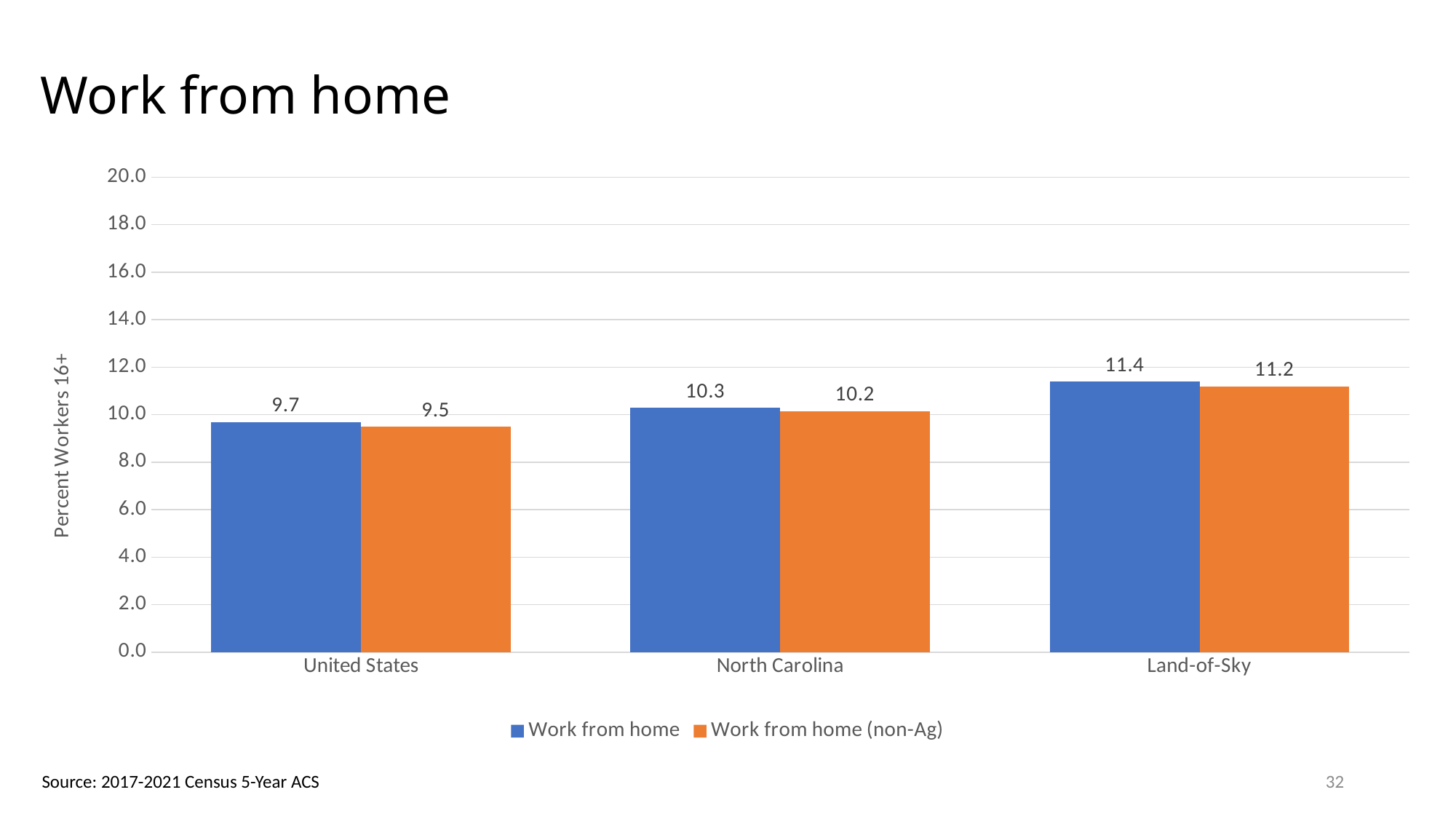
Is the 'Work from home' value for Land-of-Sky greater or less than 10.0? greater What is the 'Work from home (non-Ag)' value for North Carolina? 10.2 How many series does the legend list? 2 What is the 'Work from home' value for United States? 9.7 Which region has the lowest 'Work from home (non-Ag)' value? United States What kind of chart is shown on the slide? bar chart What is the difference between the 'Work from home' values for Land-of-Sky and United States? 1.7 Which region has the highest 'Work from home' value? Land-of-Sky What is the 'Work from home' value for Land-of-Sky? 11.4 Which is larger: the 'Work from home' value for North Carolina or for United States? North Carolina How many regions are shown on the x axis? 3 What is the label of the y axis? Percent Workers 16+